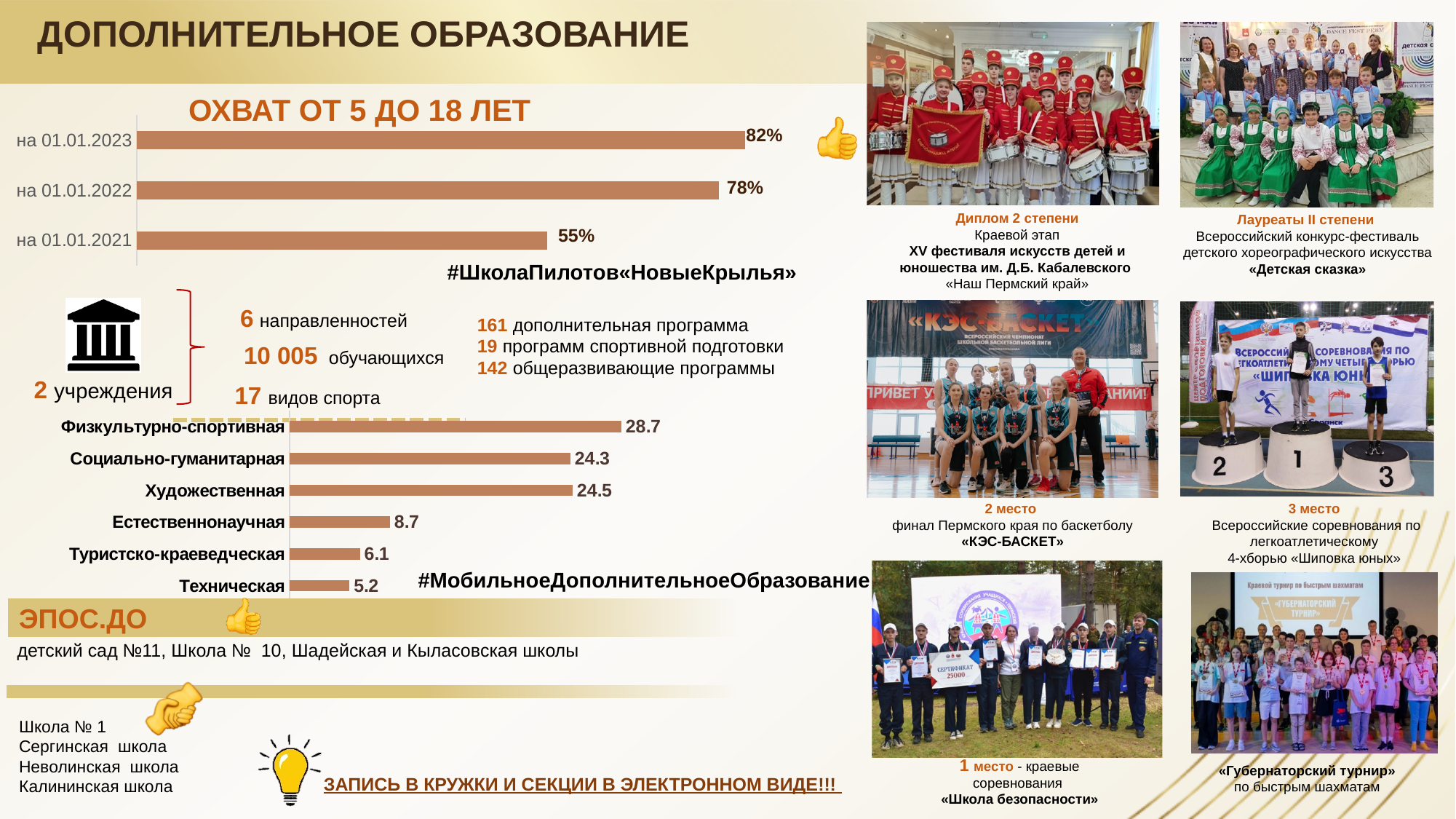
In the lower bar chart on the left side of the slide, how many categories are shown? 6 In the lower bar chart on the left side of the slide, what is the value for «Социально-гуманитарная»? 24.3 In the lower bar chart on the left side of the slide, which category has the highest value? Физкультурно-спортивная In the chart titled «ОХВАТ ОТ 5 ДО 18 ЛЕТ», what is the value for «на 01.01.2021»? 55% In the chart titled «ОХВАТ ОТ 5 ДО 18 ЛЕТ», what is the value for «на 01.01.2023»? 82% In the chart titled «ОХВАТ ОТ 5 ДО 18 ЛЕТ», do the values rise or fall from 01.01.2021 to 01.01.2023? rise In the lower bar chart on the left side of the slide, which category has the lowest value? Техническая In the lower bar chart on the left side of the slide, which is larger: «Естественнонаучная» or «Туристско-краеведческая»? Естественнонаучная In the chart titled «ОХВАТ ОТ 5 ДО 18 ЛЕТ», what is the difference between the values for «на 01.01.2023» and «на 01.01.2022»? 4% In the chart titled «ОХВАТ ОТ 5 ДО 18 ЛЕТ», which date has the lowest value? на 01.01.2021 In the chart titled «ОХВАТ ОТ 5 ДО 18 ЛЕТ», how many bars are shown? 3 What kind of chart is the lower chart on the left side of the slide (with categories such as «Физкультурно-спортивная» and «Техническая»)? bar chart